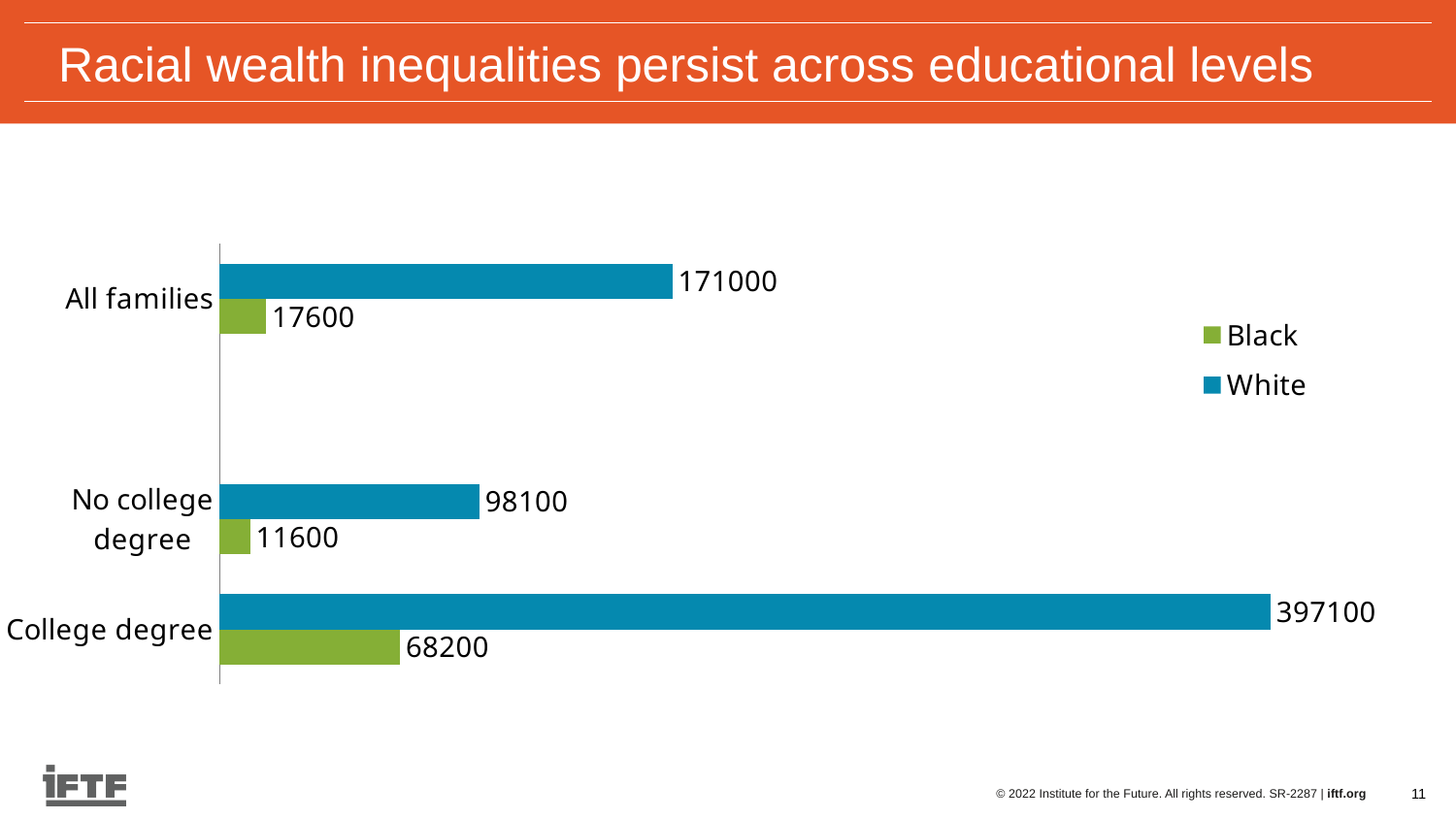
How many categories are shown on the chart? 3 What is the value for Black families in the All families category? 17600 Which category has the lowest value for the Black series? No college degree What kind of chart is shown on the slide? Bar chart What is the difference between the White and Black values for College degree? 328900 Which category has the highest value for the White series? College degree What is the value for Black families with no college degree? 11600 What is the difference between the White and Black values for All families? 153400 How many series does the legend list? 2 Which is larger: the Black value for College degree or the White value for No college degree? White value for No college degree What is the value for White families with no college degree? 98100 What is the value for White families with a college degree? 397100